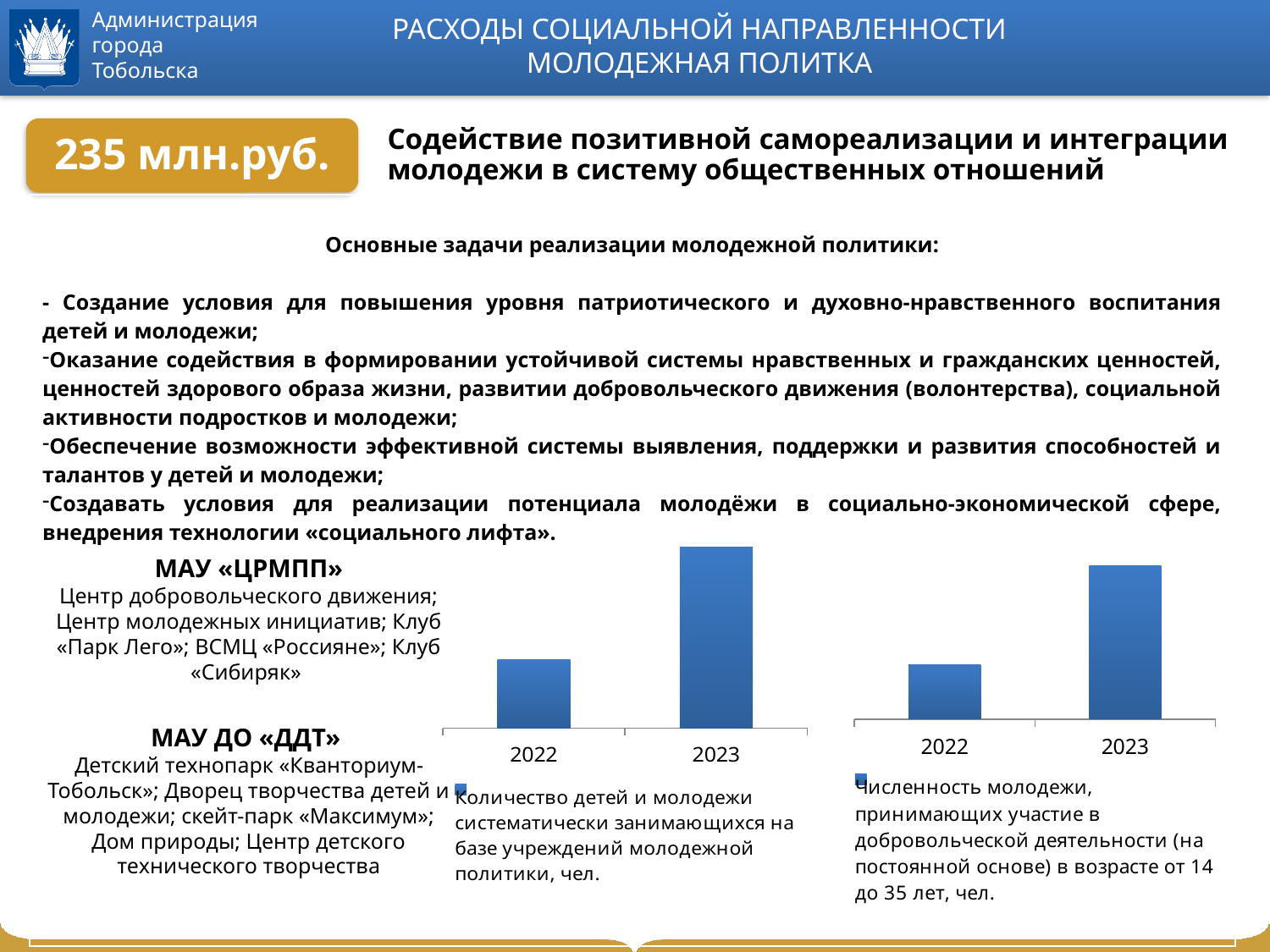
How many categories are shown on the x axis of the left chart? 2 What are the two category labels on the x axis of the right chart? 2022 and 2023 In the left chart, which year has the higher value, 2022 or 2023? 2023 In the left chart, which category has the highest value? 2023 In the right chart, do the values rise or fall from 2022 to 2023? rise In the left chart, do the values rise or fall from 2022 to 2023? rise What kind of chart is the right chart on the slide? bar chart In the right chart, which year has the lower value, 2022 or 2023? 2022 What kind of chart is the left chart on the slide? bar chart How many categories are shown on the x axis of the right chart? 2 In the right chart, which category has the lowest value? 2022 How many series does the legend of the left chart list? 1